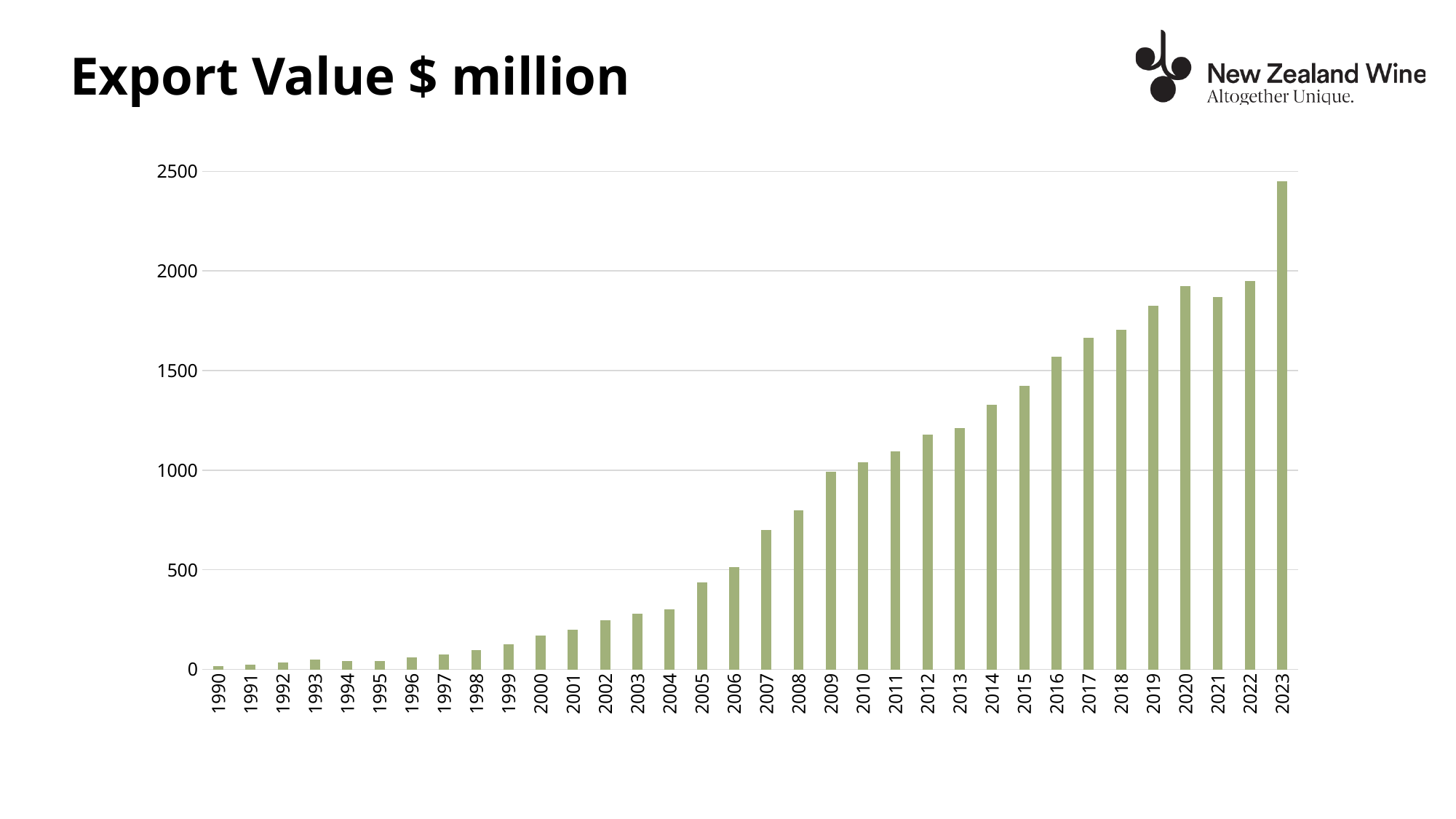
What is the title of the chart? Export Value $ million Do export values generally rise or fall from 1990 to 2023? rise Which year has the lowest export value? 1990 Is the export value for 2023 greater or less than 2000? greater Is the export value for 2014 greater or less than 1000? greater Which year has the larger export value, 2022 or 2023? 2023 What kind of chart is shown on the slide? bar chart Is the export value for 2016 greater or less than 1500? greater Which year has the highest export value? 2023 How many years are shown on the x axis of the chart? 34